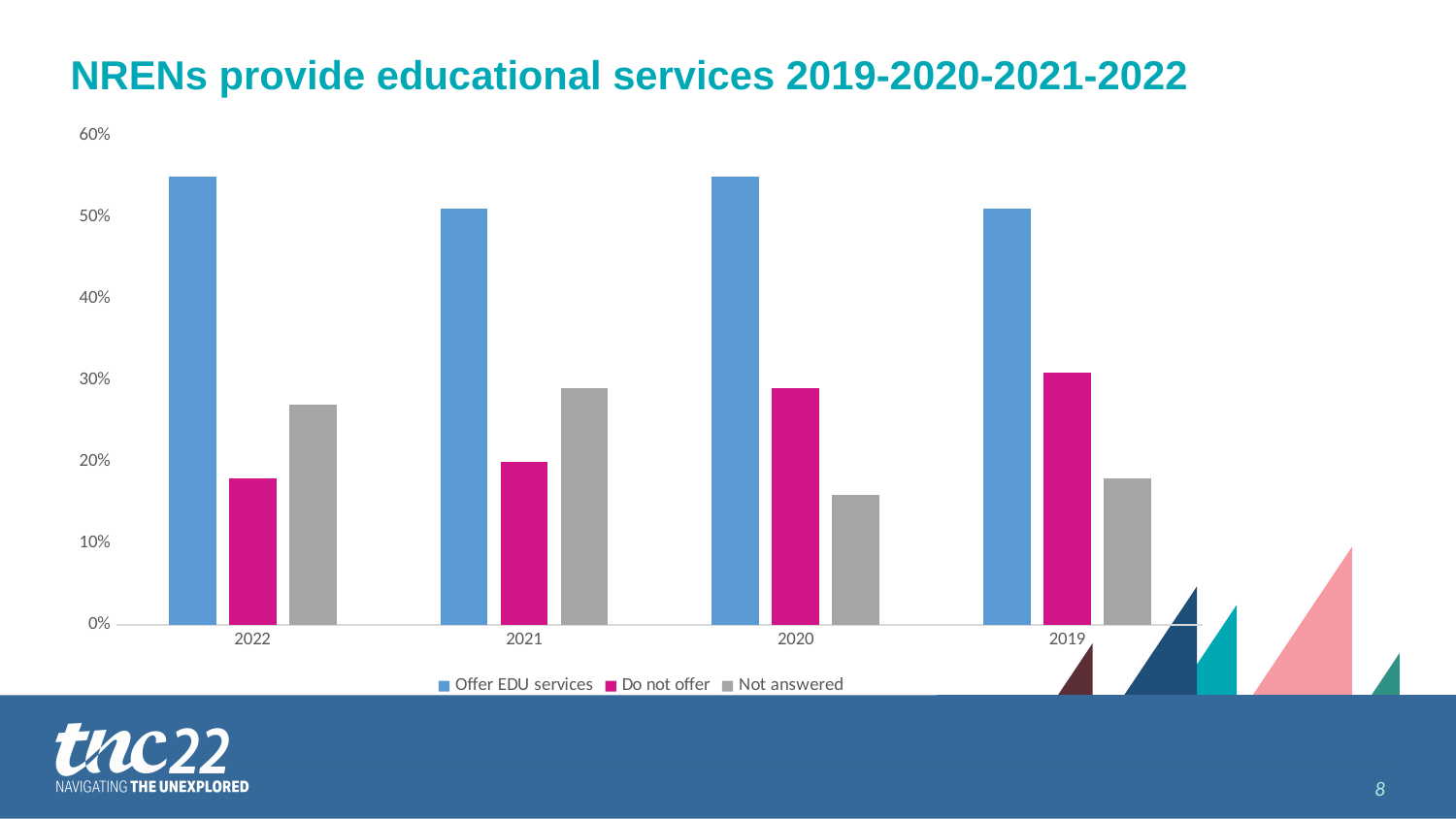
In 2020, which is larger: 'Offer EDU services' or 'Do not offer'? Offer EDU services Is the value for 'Offer EDU services' in 2022 greater or less than 50%? greater What kind of chart is shown on the slide? bar chart How many series does the chart's legend list? 3 How many years (categories) are shown on the x axis of the chart? 4 In 2022, which is larger: 'Do not offer' or 'Not answered'? Not answered Which series is shown in pink/magenta in the chart? Do not offer In 2019, which is larger: 'Do not offer' or 'Not answered'? Do not offer What is the title of the chart on the slide? NRENs provide educational services 2019-2020-2021-2022 Is the value for 'Not answered' in 2020 greater or less than 20%? less Is the value for 'Do not offer' in 2020 greater or less than 20%? greater